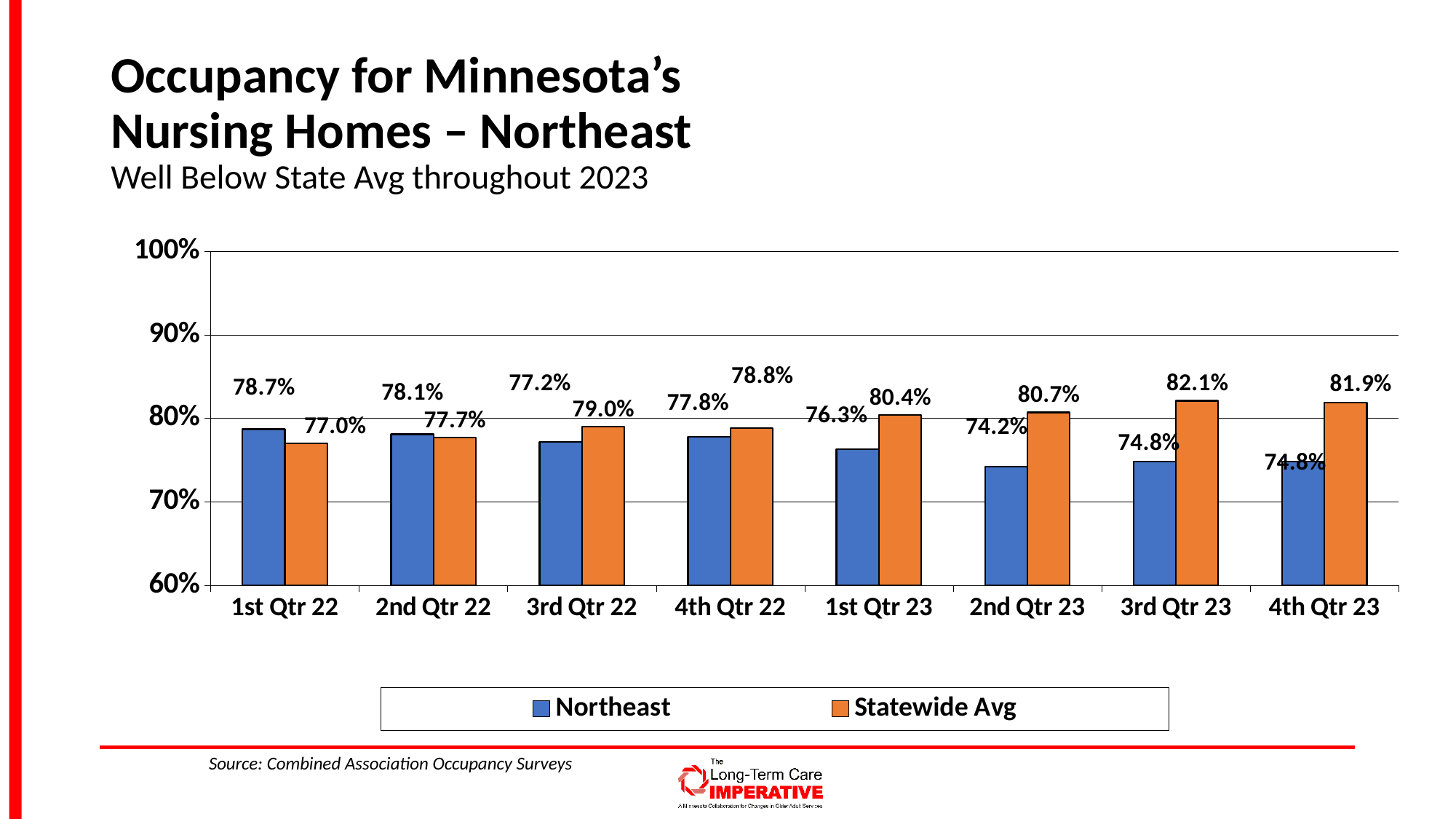
What is the difference between the Statewide Avg and Northeast values in 4th Qtr 23? 7.1 percentage points In which quarter is the Statewide Avg occupancy highest? 3rd Qtr 23 In 1st Qtr 22, which is larger: the Northeast value or the Statewide Avg value? Northeast How many quarters are shown on the x axis? 8 What colour are the Statewide Avg bars? Orange What is the Statewide Avg occupancy value for 3rd Qtr 23? 82.1% How many series does the legend list? 2 What is the Northeast occupancy value for 1st Qtr 22? 78.7% What kind of chart is shown on the slide? Bar chart What is the Northeast occupancy value for 2nd Qtr 23? 74.2% Do the Northeast values generally rise or fall from 1st Qtr 22 to 4th Qtr 23? Fall In which quarter is the Northeast occupancy lowest? 2nd Qtr 23